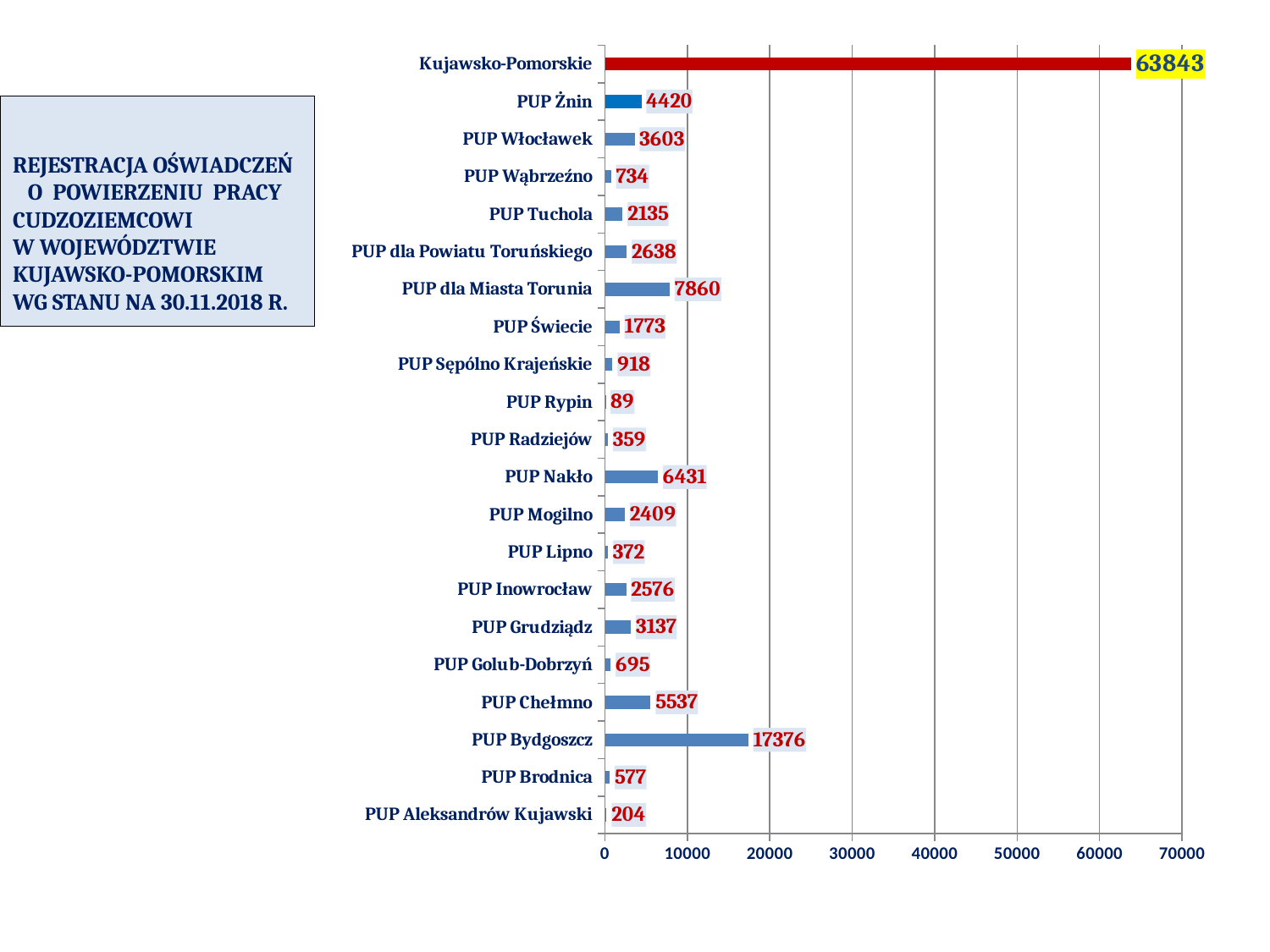
What is the value for PUP Bydgoszcz? 17376 Which is larger, the value for PUP Nakło or the value for PUP Żnin? PUP Nakło What is the difference between the values for PUP Bydgoszcz and PUP Chełmno? 11839 Is the value for PUP Bydgoszcz greater or less than 10000? greater What is the value for PUP dla Miasta Torunia? 7860 What is the value for PUP Rypin? 89 What is the value for Kujawsko-Pomorskie? 63843 What kind of chart is shown on the slide? bar chart What is the difference between the values for PUP dla Miasta Torunia and PUP dla Powiatu Toruńskiego? 5222 How many categories are shown on the chart? 21 Which category has the lowest value? PUP Rypin Which category has the highest value? Kujawsko-Pomorskie